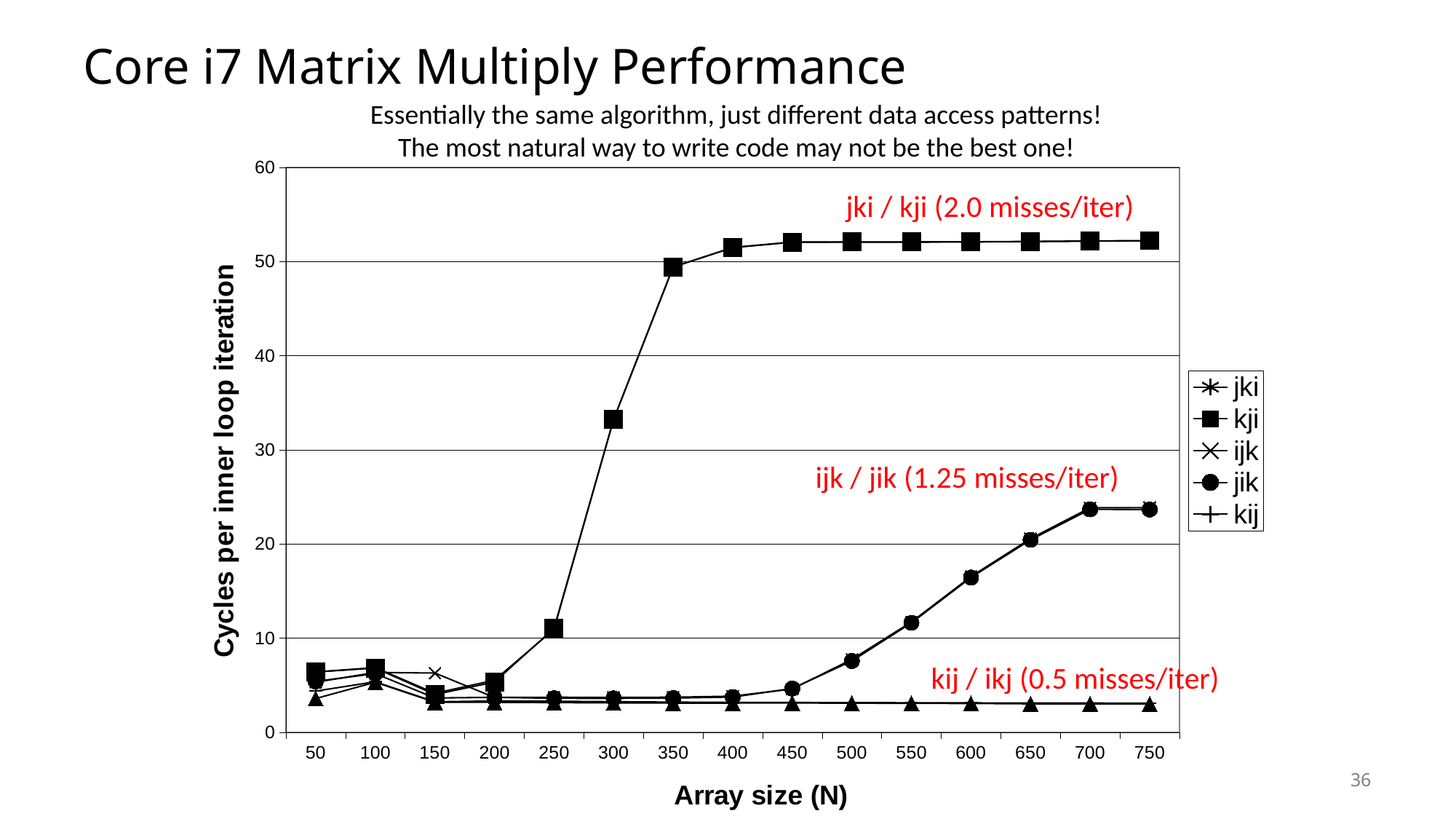
How many series does the legend list? 5 Is the value for kji at array size 250 greater or less than 20? less Is the value for kji at array size 300 greater or less than 30? greater What is the title of the y axis? Cycles per inner loop iteration What kind of chart is shown on the slide? line chart Does the kji series rise or fall as the array size goes from 200 to 450? rise How many array size values are marked along the x axis? 15 At array size 750, which is larger: the value for kji or the value for jik? kji Is the value for kij at array size 750 greater or less than 10? less What is the title of the x axis? Array size (N)